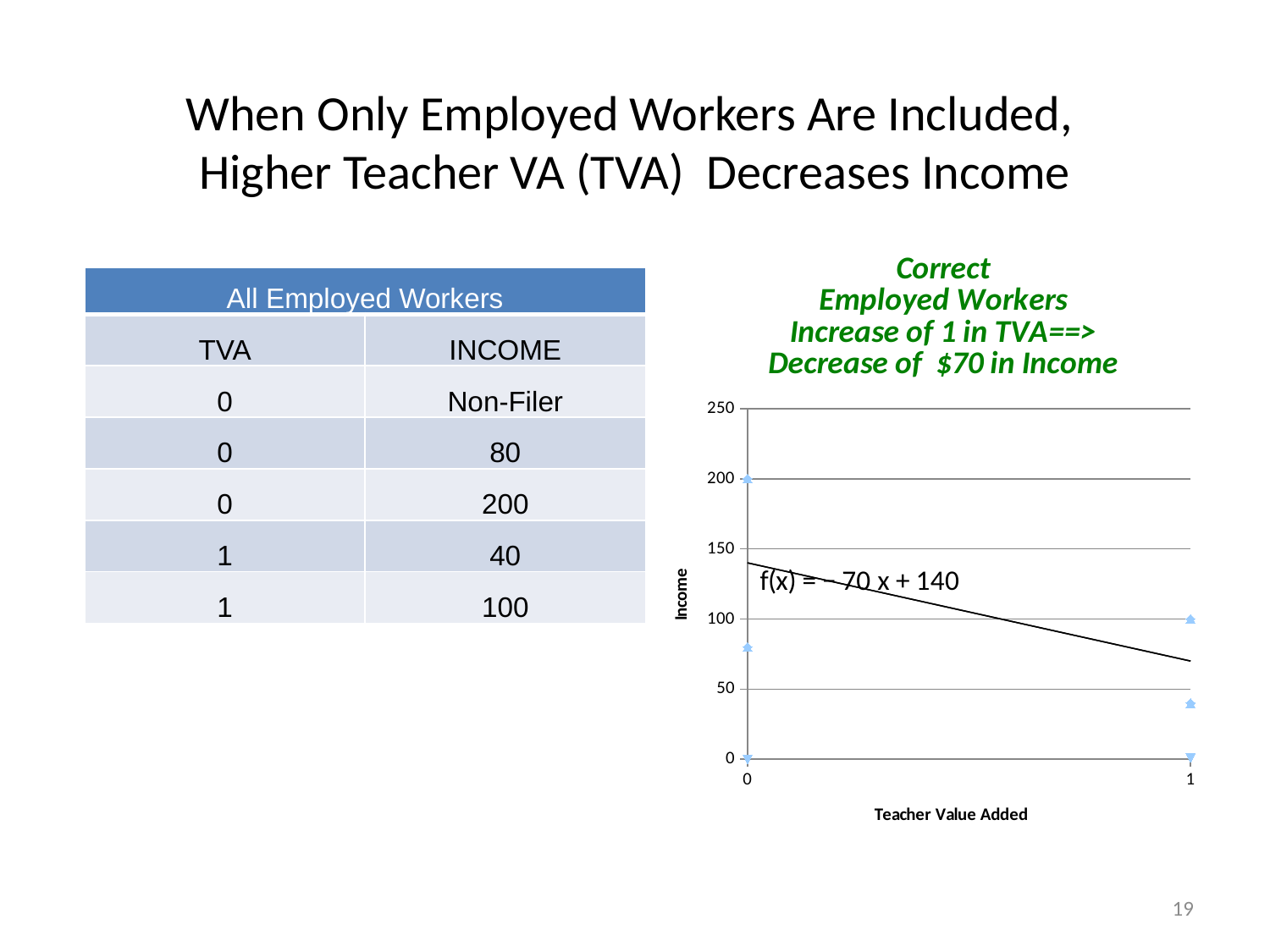
Is the middle plotted Income point at Teacher Value Added 1 greater or less than 50? less What is the highest Income value plotted at Teacher Value Added 0? 200 Is the middle plotted Income point at Teacher Value Added 0 greater or less than 100? less Which has the higher top plotted Income value: Teacher Value Added 0 or Teacher Value Added 1? Teacher Value Added 0 What is the highest Income value plotted at Teacher Value Added 1? 100 What is the difference between the highest plotted Income at Teacher Value Added 0 and the highest plotted Income at Teacher Value Added 1? 100 Does the trend line on the chart rise or fall as Teacher Value Added increases from 0 to 1? fall What kind of chart is shown on the slide? scatter chart What is the equation of the trend line shown on the chart? f(x) = -70 x + 140 What is the title of the x axis of the chart? Teacher Value Added How many data points are plotted on the chart? 6